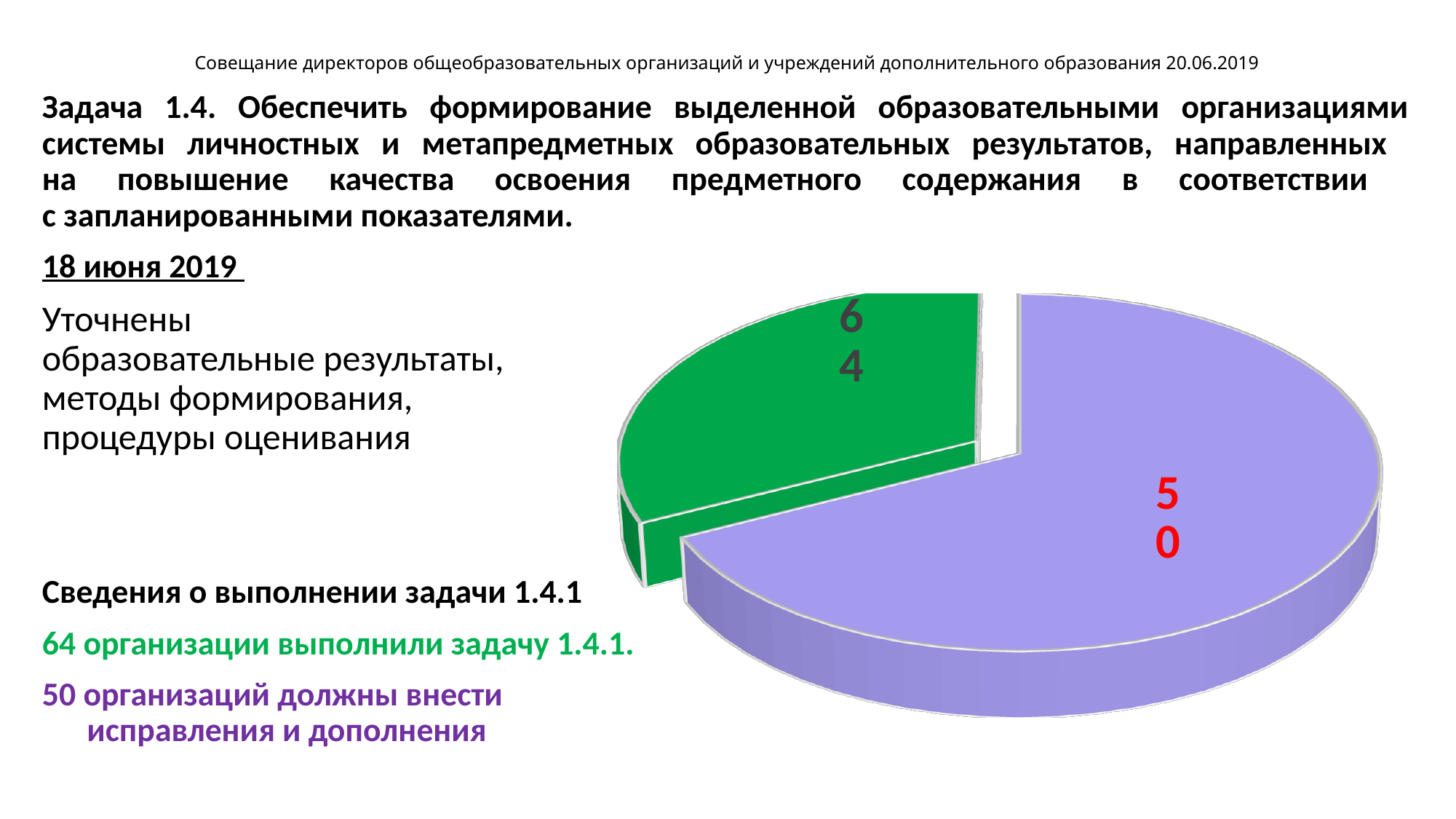
What kind of chart is shown on the slide? pie chart Which printed value on the pie chart is larger, the one on the green slice or the one on the purple slice? the green slice (64) What colour is the slice labelled 64? green How many slices does the pie chart have? 2 What value is printed on the green slice of the pie chart? 64 What value is printed on the purple slice of the pie chart? 50 What colour is the slice labelled 50? purple What is the difference between the two values printed on the pie chart, 64 and 50? 14